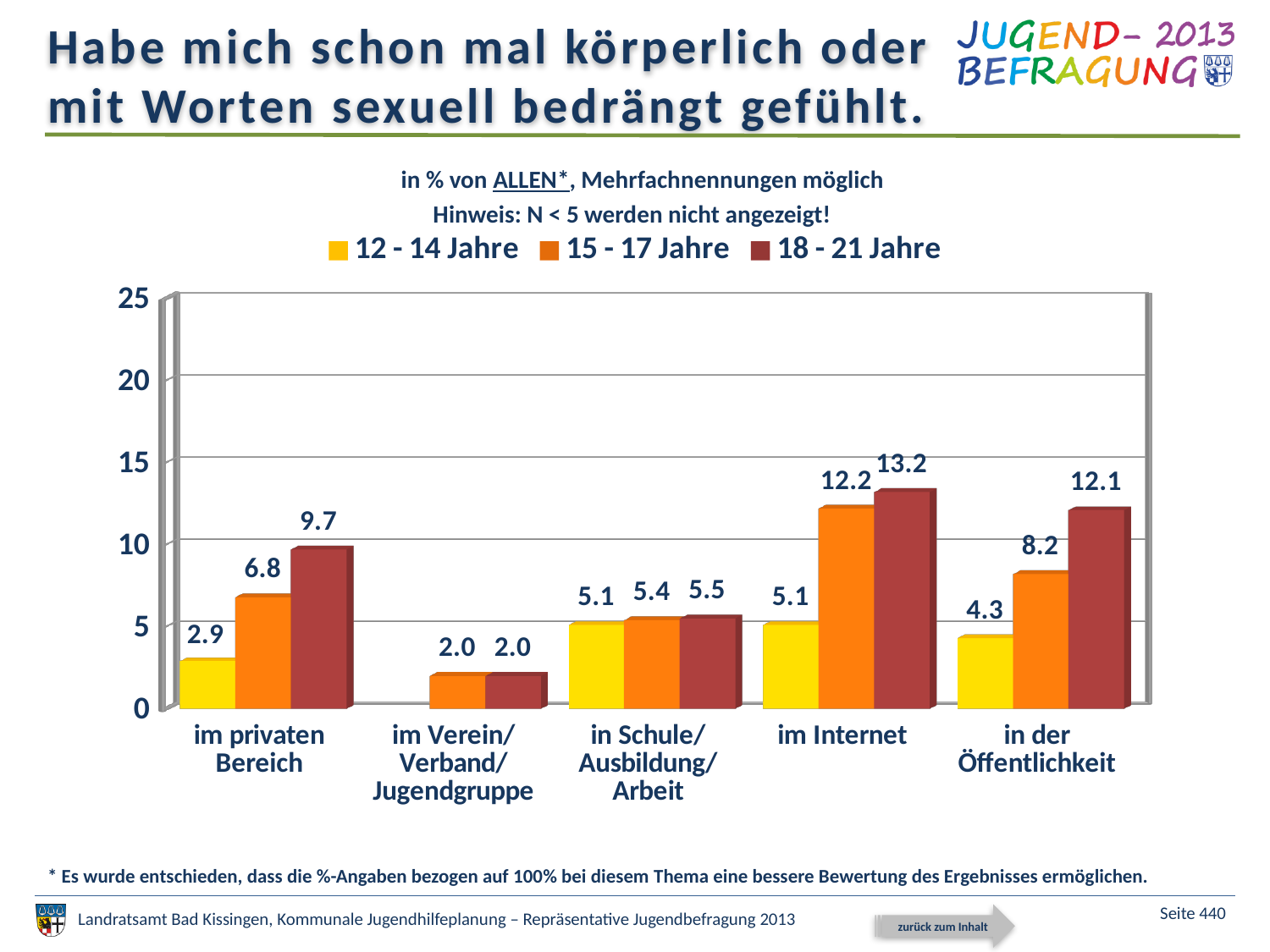
Which is larger: the 15 - 17 Jahre value for 'in der Öffentlichkeit' or the 15 - 17 Jahre value for 'im privaten Bereich'? in der Öffentlichkeit Which category has the lowest value for the 15 - 17 Jahre series? im Verein/Verband/Jugendgruppe Which series is shown in yellow in the legend? 12 - 14 Jahre What kind of chart is shown on the slide? bar chart How many categories are shown on the x axis? 5 What is the value for the 18 - 21 Jahre series in the category 'im privaten Bereich'? 9.7 What is the difference between the 18 - 21 Jahre and 12 - 14 Jahre values in the category 'im Internet'? 8.1 How many series does the legend list? 3 Which category has the highest value for the 18 - 21 Jahre series? im Internet Is the value for the 18 - 21 Jahre series in 'im Internet' greater or less than 10? greater What is the value for the 15 - 17 Jahre series in the category 'im Internet'? 12.2 What is the value for the 12 - 14 Jahre series in the category 'in der Öffentlichkeit'? 4.3